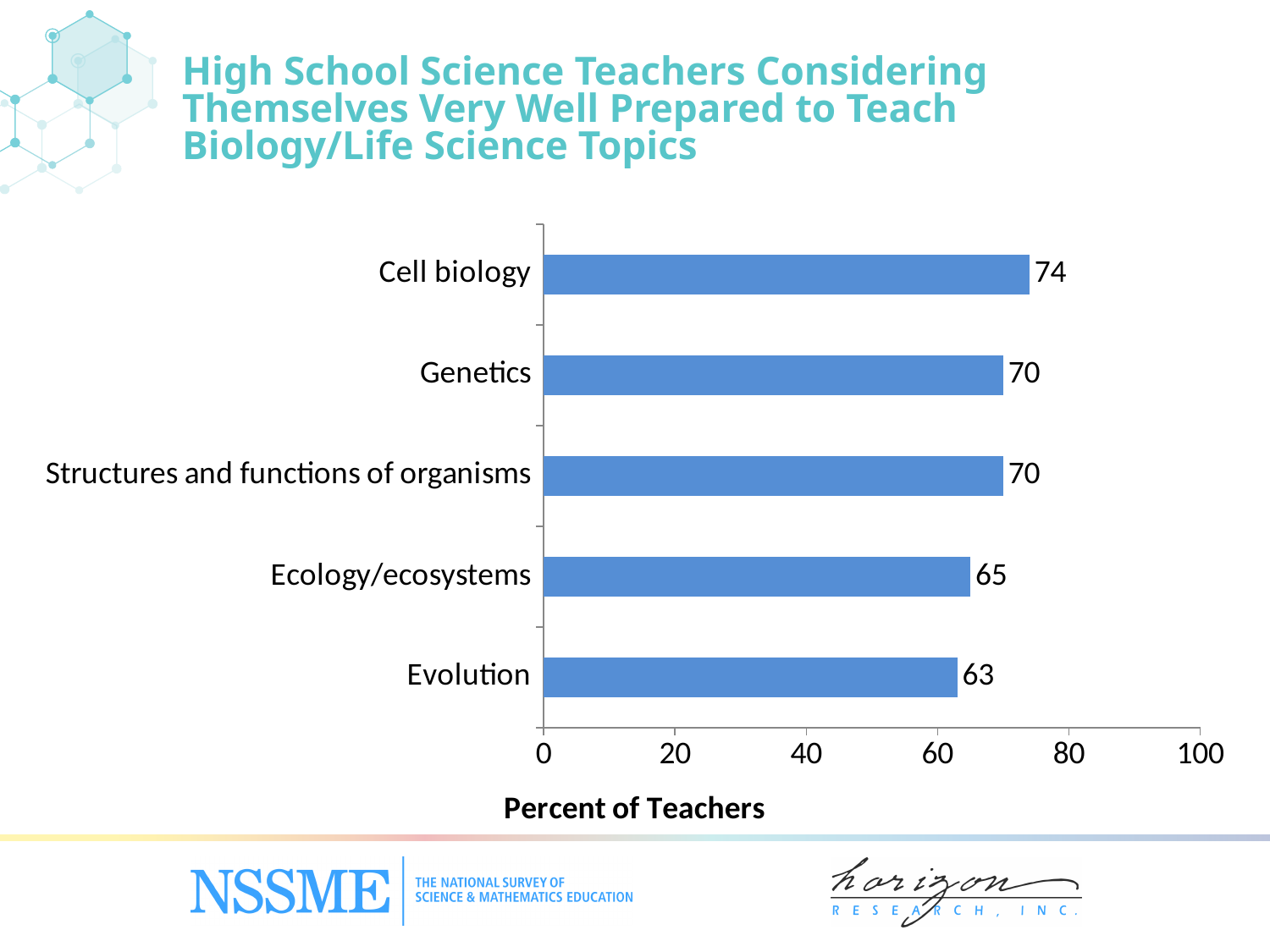
What is the value for Evolution? 63 What is the value for Ecology/ecosystems? 65 Which is larger, the value for Ecology/ecosystems or the value for Evolution? Ecology/ecosystems Which topic has the lowest percent of teachers? Evolution What is the label of the horizontal axis? Percent of Teachers What kind of chart is shown on the slide? Bar chart Is the value for Genetics greater or less than 60? greater How many topics are shown in the chart? 5 Which topic has the highest percent of teachers? Cell biology What is the difference between the values for Cell biology and Evolution? 11 What is the difference between the values for Genetics and Ecology/ecosystems? 5 What percent of teachers consider themselves very well prepared to teach Cell biology? 74